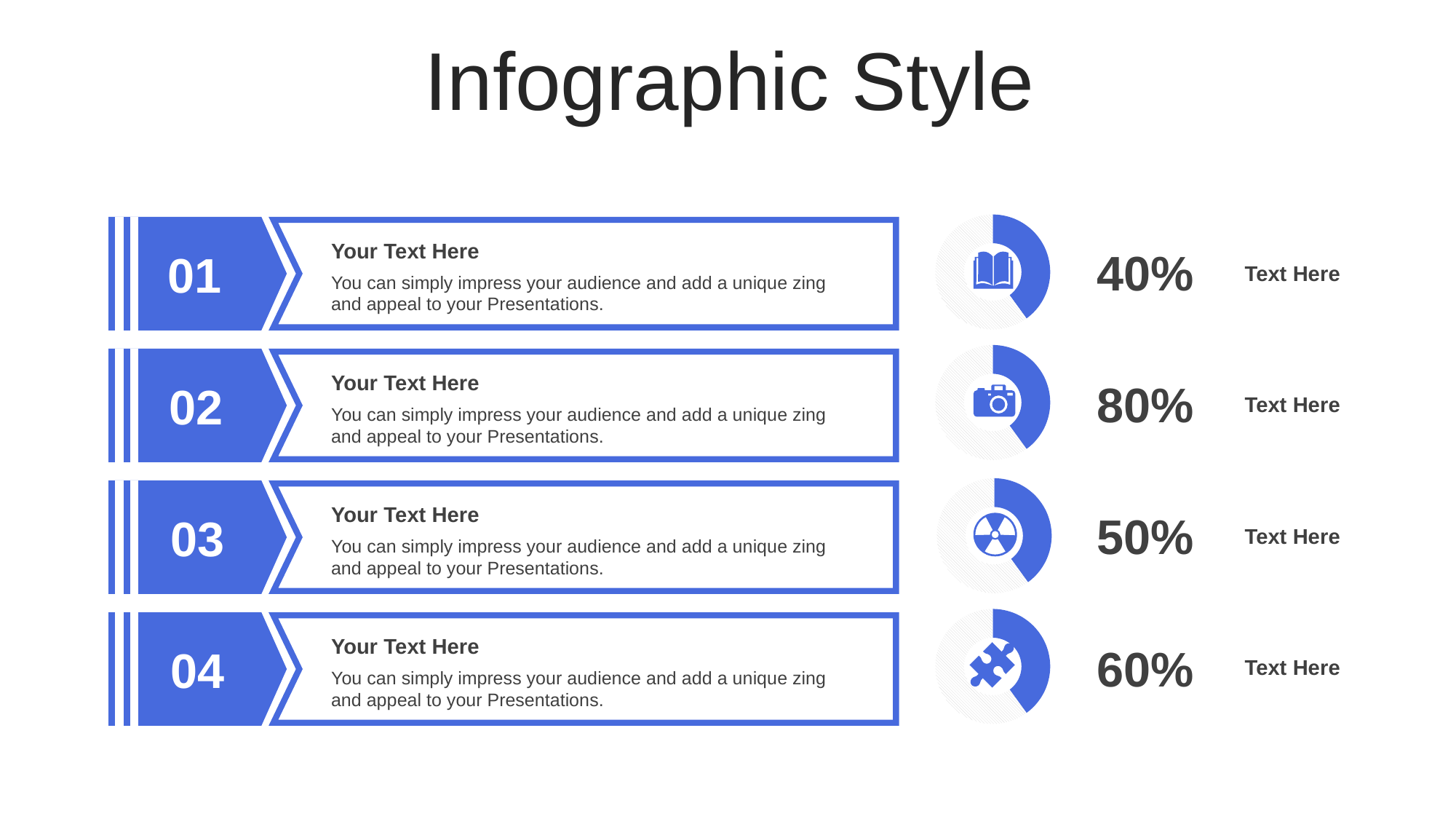
What colour is the filled portion of each donut chart? Blue What percentage is shown next to the bottom donut chart (the one with the puzzle icon)? 60% What kind of chart is used to show the percentages on the right side of the slide? Donut (pie) chart What percentage is shown next to the second donut chart (the one with the camera icon)? 80% What percentage is shown next to the third donut chart (the one with the radiation icon)? 50% How many donut charts are shown on the slide? 4 Which of the four donut charts shows the lowest percentage? The top one (book icon), 40% What percentage is shown next to the top donut chart (the one with the book icon)? 40% What is the difference between the percentage of the second donut chart and the top donut chart? 40% What is the difference between the percentages of the bottom donut chart and the third donut chart? 10% Which of the four donut charts shows the highest percentage? The second one (camera icon), 80% Which is larger, the percentage of the third donut chart or the bottom donut chart? The bottom donut chart (60%)